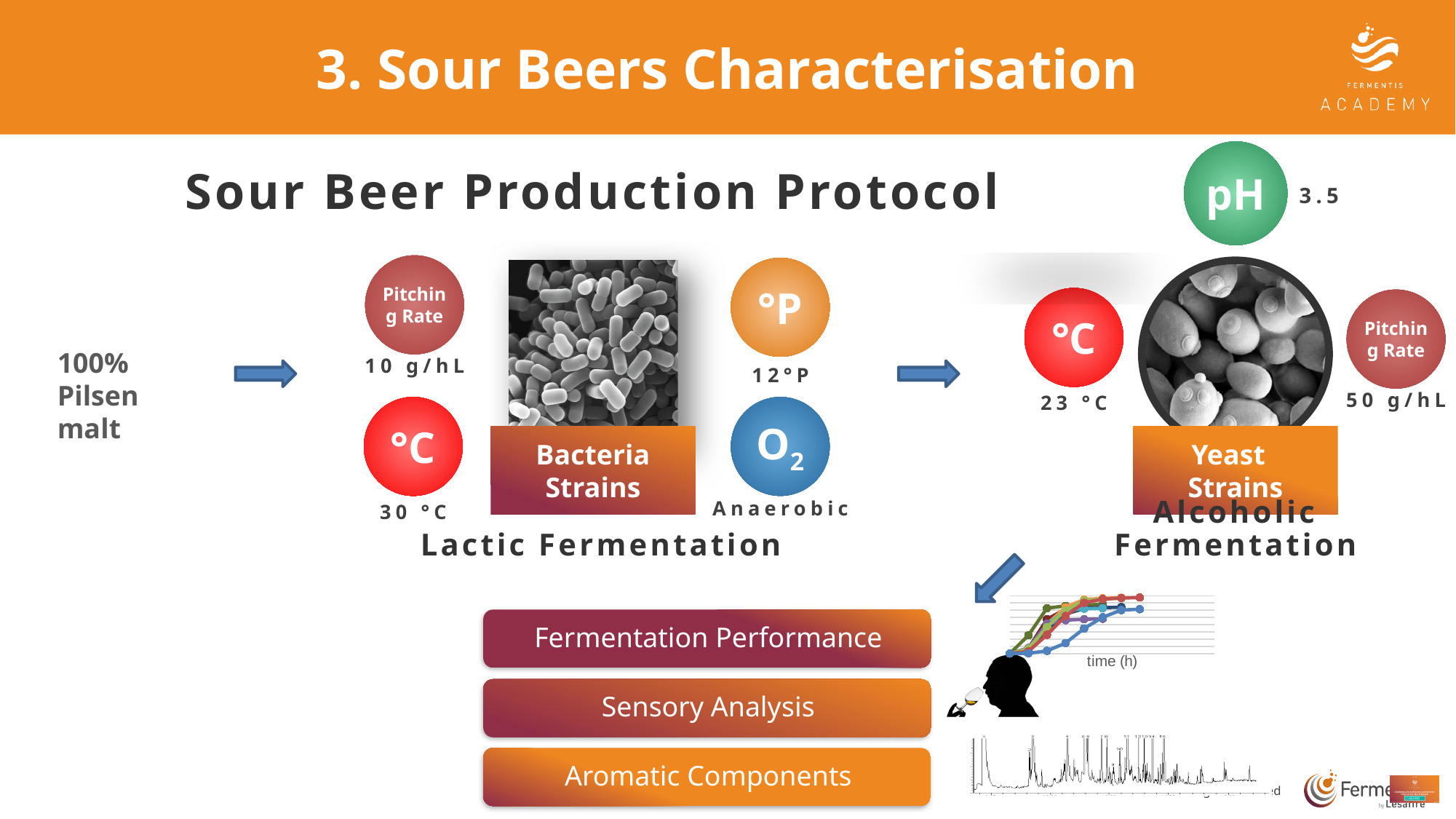
What kind of chart is the small chart next to the 'Fermentation Performance' box? line chart What is the x-axis label of the small line chart near the 'Fermentation Performance' box? time (h) In the small line chart near the 'Fermentation Performance' box, do the plotted values rise or fall along the x axis? rise